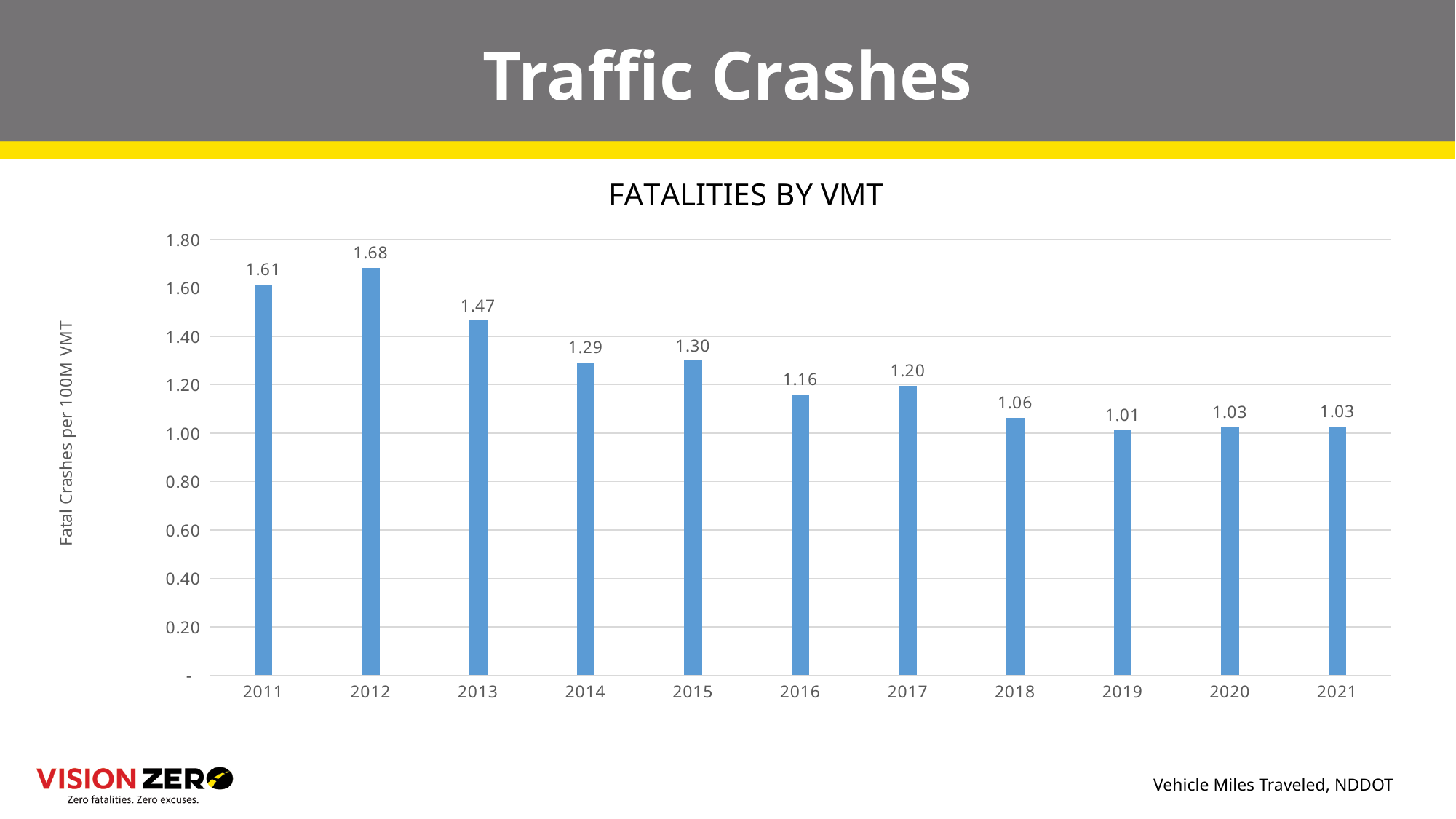
Which year has the lowest value? 2019 What kind of chart is this? bar chart Do the values generally rise or fall from 2011 to 2021? fall What is the value for 2011? 1.61 Which is larger, the value for 2014 or the value for 2016? 2014 Is the value for 2013 greater or less than 1.40? greater How many years are shown on the x axis? 11 What is the difference between the values for 2012 and 2013? 0.21 What is the difference between the values for 2011 and 2021? 0.58 What is the value for 2021? 1.03 Which year has the highest value? 2012 What is the value for 2017? 1.20